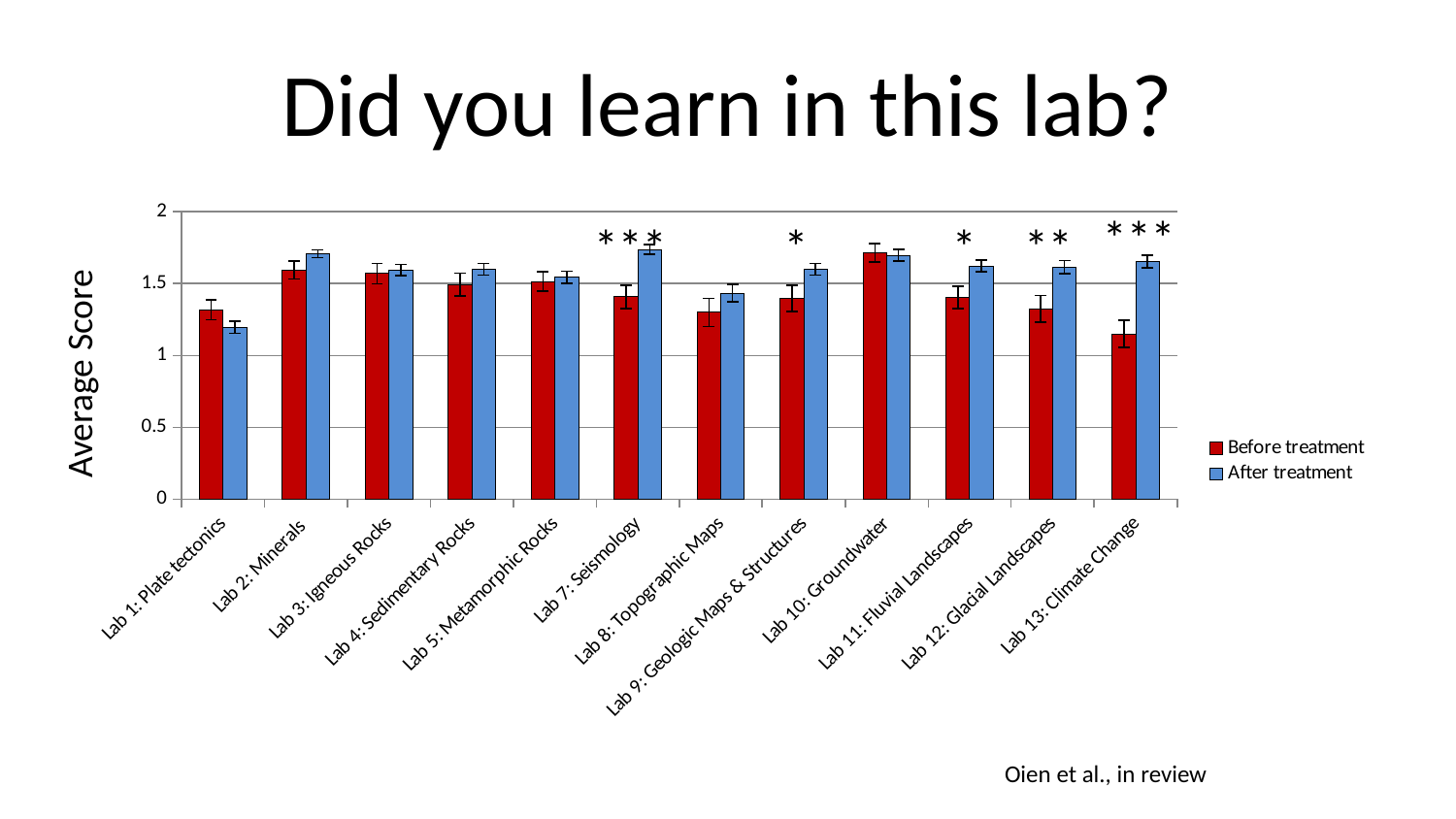
Which lab has the highest Before treatment value? Lab 10: Groundwater What is the label on the vertical axis of the chart? Average Score What kind of chart is shown on the slide? bar chart Is the Before treatment value for Lab 1: Plate tectonics greater or less than 1? greater For Lab 13: Climate Change, which is larger, the Before treatment or the After treatment value? After treatment Is the After treatment value for Lab 1: Plate tectonics greater or less than 1.5? less Is the Before treatment value for Lab 13: Climate Change greater or less than 1.5? less How many series does the legend list? 2 Which lab has the lowest After treatment value? Lab 1: Plate tectonics For Lab 1: Plate tectonics, which is larger, the Before treatment or the After treatment value? Before treatment How many lab categories are plotted along the x axis? 12